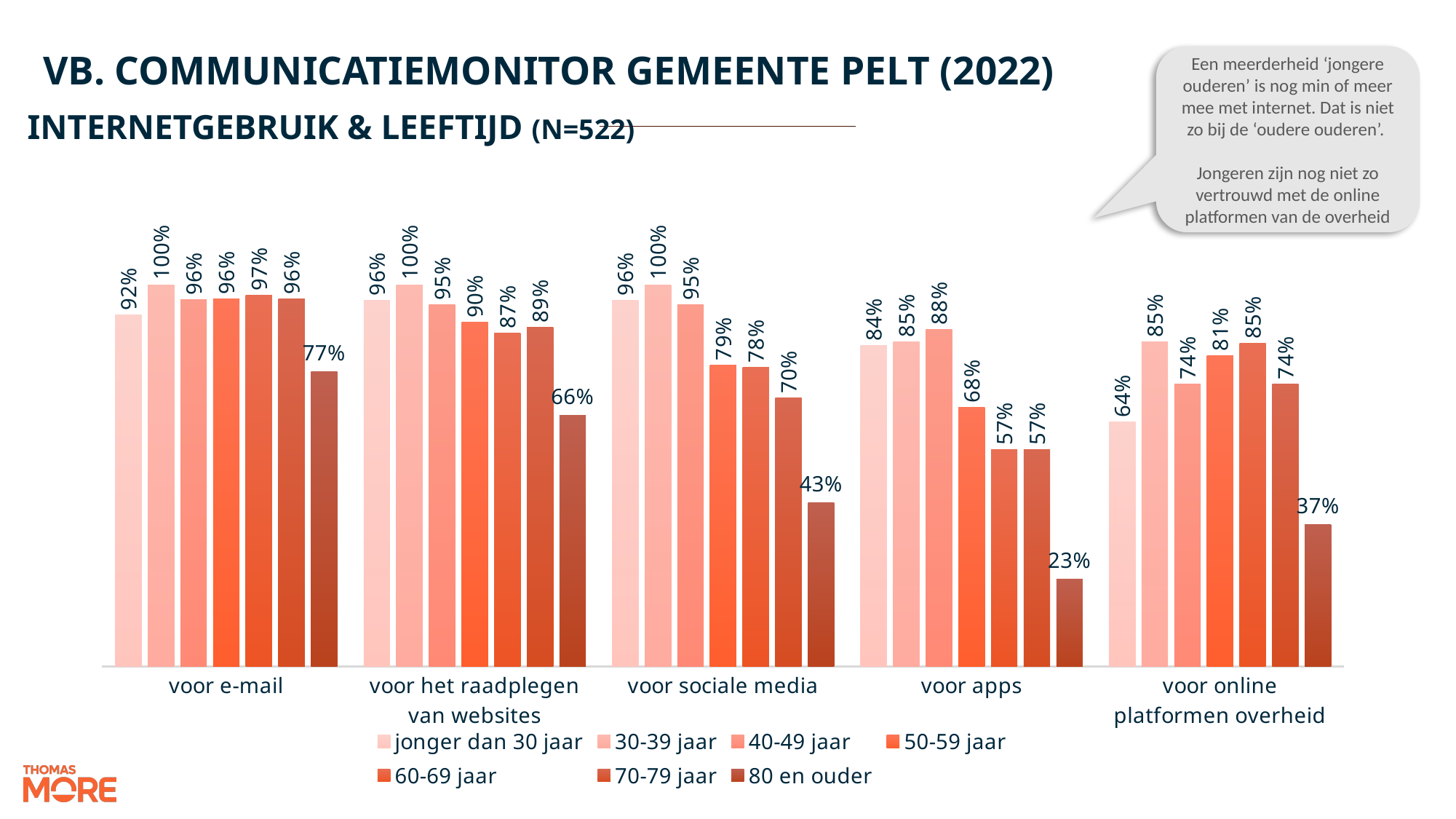
How many series does the legend list? 7 What is the value for 'jonger dan 30 jaar' in the 'voor online platformen overheid' category? 64% Which is larger in the 'voor het raadplegen van websites' category: the value for '50-59 jaar' or for '60-69 jaar'? 50-59 jaar What is the value for '80 en ouder' in the 'voor apps' category? 23% Does the value for '80 en ouder' rise or fall from 'voor e-mail' to 'voor apps' across the x axis? fall How many categories are shown on the x axis? 5 What is the sample size (N) stated in the chart subtitle? N=522 Which age group has the lowest value in the 'voor e-mail' category? 80 en ouder What is the value for '30-39 jaar' in the 'voor sociale media' category? 100% What is the difference between the '30-39 jaar' and '80 en ouder' values in the 'voor sociale media' category? 57% What kind of chart is shown on the slide? bar chart Which age group has the highest value in the 'voor apps' category? 40-49 jaar